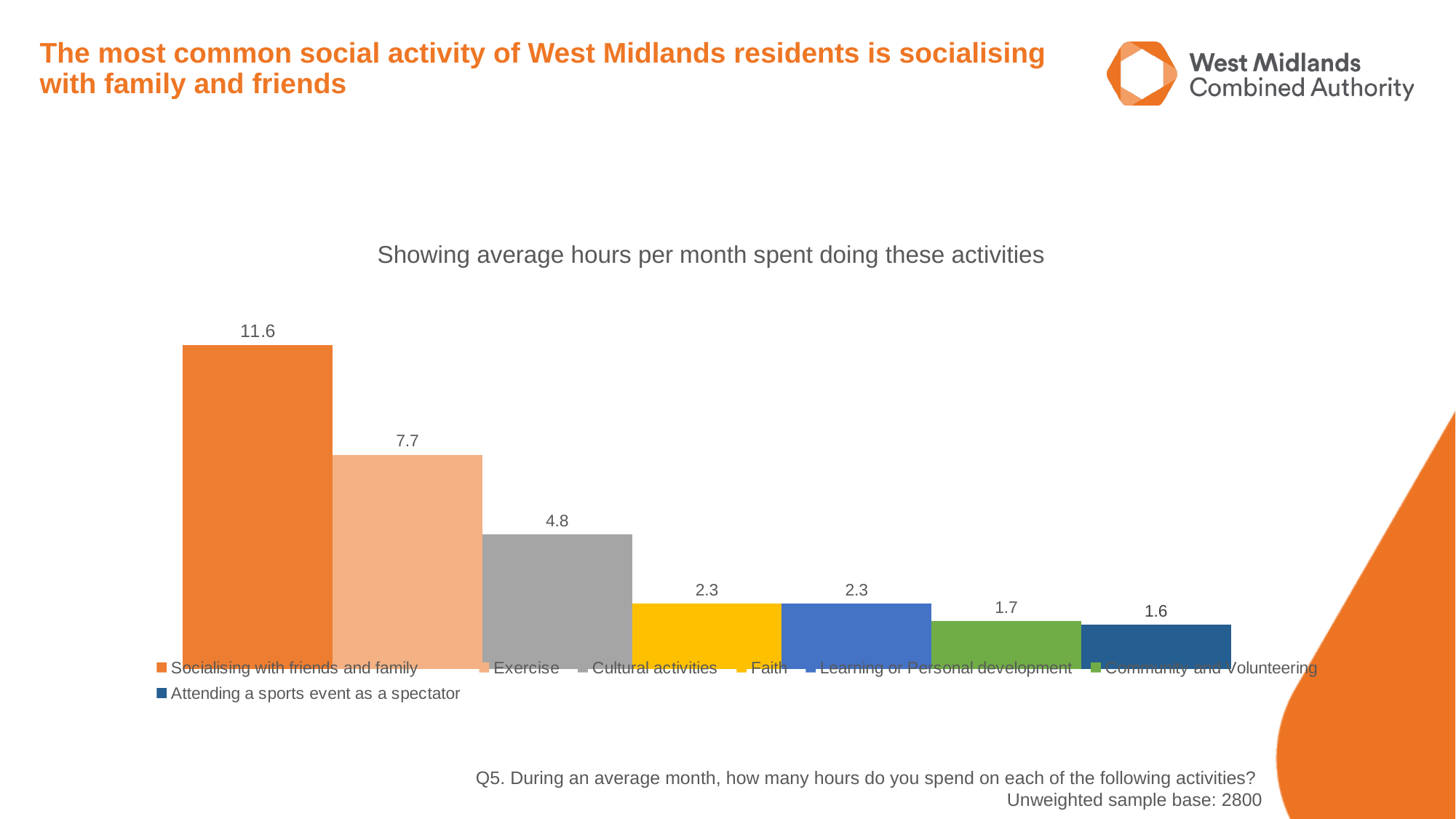
What is the value shown for Cultural activities? 4.8 Which is larger, the value for Exercise or the value for Cultural activities? Exercise What is the difference between the values for Cultural activities and Faith? 2.5 What kind of chart is shown on the slide? Bar chart What is the value shown for Attending a sports event as a spectator? 1.6 How many bars are plotted in the chart? 7 How many entries does the legend list? 7 Which activity has the highest average hours per month? Socialising with friends and family What is the average hours per month for Socialising with friends and family? 11.6 Which activity has the lowest average hours per month? Attending a sports event as a spectator What is the value shown for Exercise? 7.7 What is the difference between the values for Socialising with friends and family and Exercise? 3.9